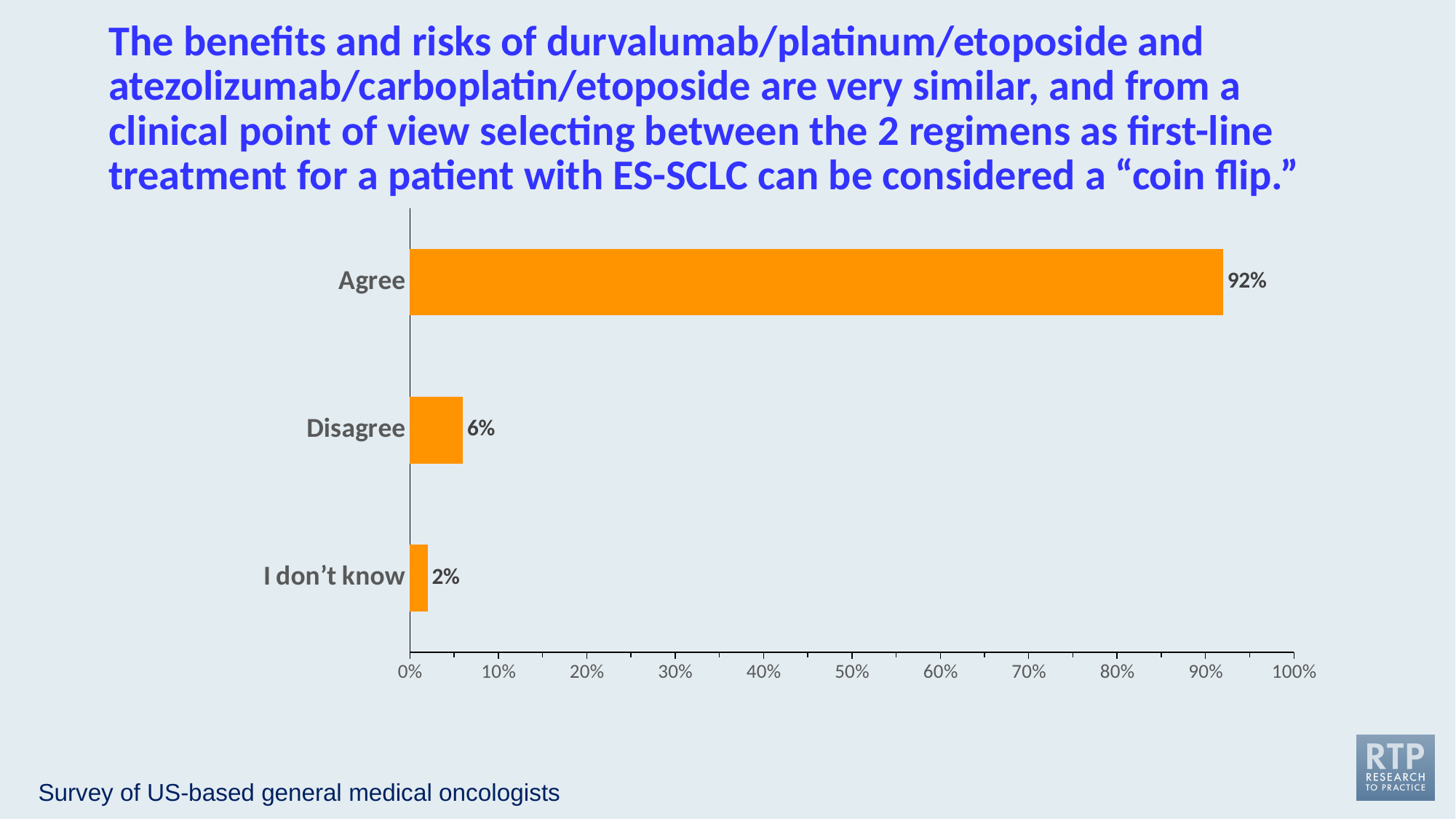
What is the maximum value shown on the horizontal axis? 100% What is the difference between the "Disagree" and "I don't know" percentages? 4% Which response category has the highest value? Agree What percentage of respondents chose "I don't know"? 2% What is the difference between the "Agree" and "Disagree" percentages? 86% What type of chart is shown on the slide? Bar chart Which is larger, the value for "Disagree" or the value for "I don't know"? Disagree Which response category has the lowest value? I don't know What percentage of respondents chose "Agree"? 92% How many response categories are shown in the chart? 3 Is the value for "Agree" greater or less than 90%? greater What percentage of respondents chose "Disagree"? 6%